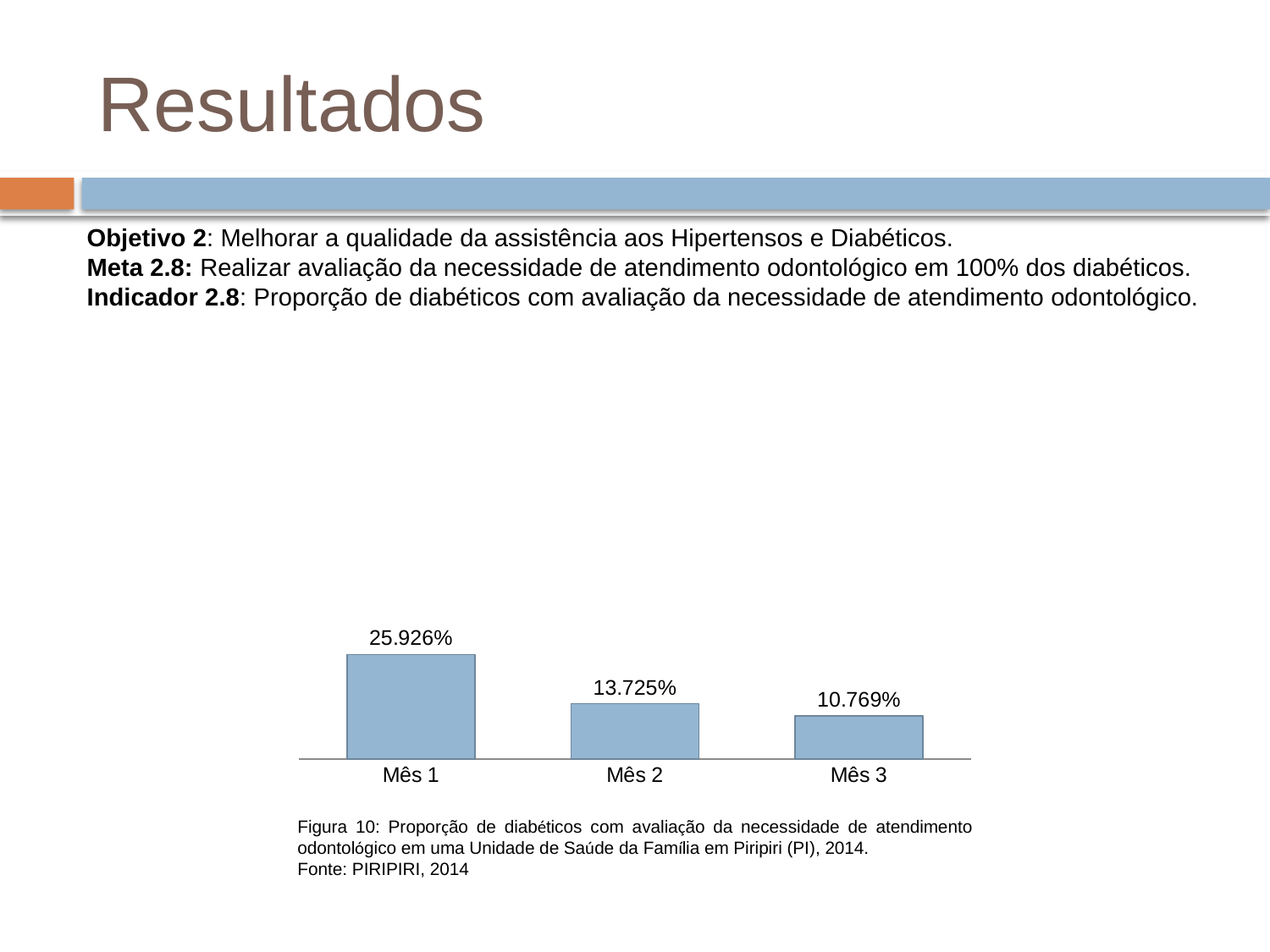
What is the difference between the values for Mês 1 and Mês 3? 15.157% What is the value for Mês 2? 13.725% Do the values rise or fall from Mês 1 to Mês 3? Fall What is the value for Mês 3? 10.769% What is the difference between the values for Mês 1 and Mês 2? 12.201% Which month has the highest value? Mês 1 What kind of chart is shown on the slide? Bar chart How many categories are shown on the x axis? 3 Which month has the lowest value? Mês 3 What is the difference between the values for Mês 2 and Mês 3? 2.956% Which is larger, the value for Mês 2 or the value for Mês 3? Mês 2 What is the value for Mês 1? 25.926%